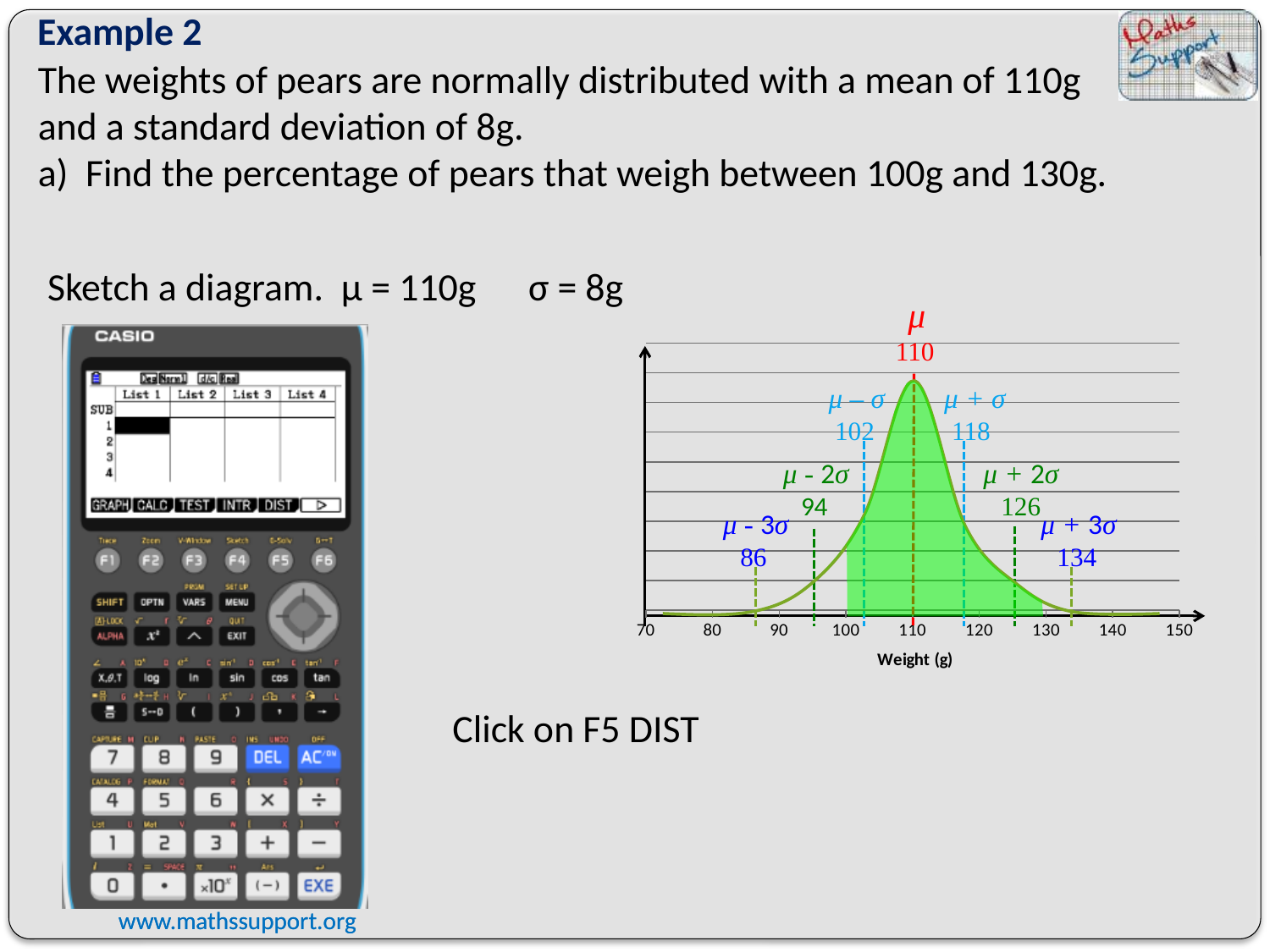
What weight value is labelled at μ − σ on the chart? 102 What kind of chart is shown on the slide? Normal distribution (bell) curve What is the difference between the values labelled at μ + 3σ and μ − 3σ on the chart? 48 What weight value is labelled at μ − 3σ on the chart? 86 What is the difference between the values labelled at μ + σ and μ − σ on the chart? 16 What weight value is labelled at μ + 3σ on the chart? 134 At what weight does the curve reach its highest point? 110 What weight value is labelled at μ + σ on the chart? 118 What weight value is labelled at the mean μ on the chart? 110 What is the label on the horizontal axis of the normal distribution chart? Weight (g) Between which two weights on the x axis is the area under the curve shaded green? 100 and 130 What weight value is labelled at μ − 2σ on the chart? 94